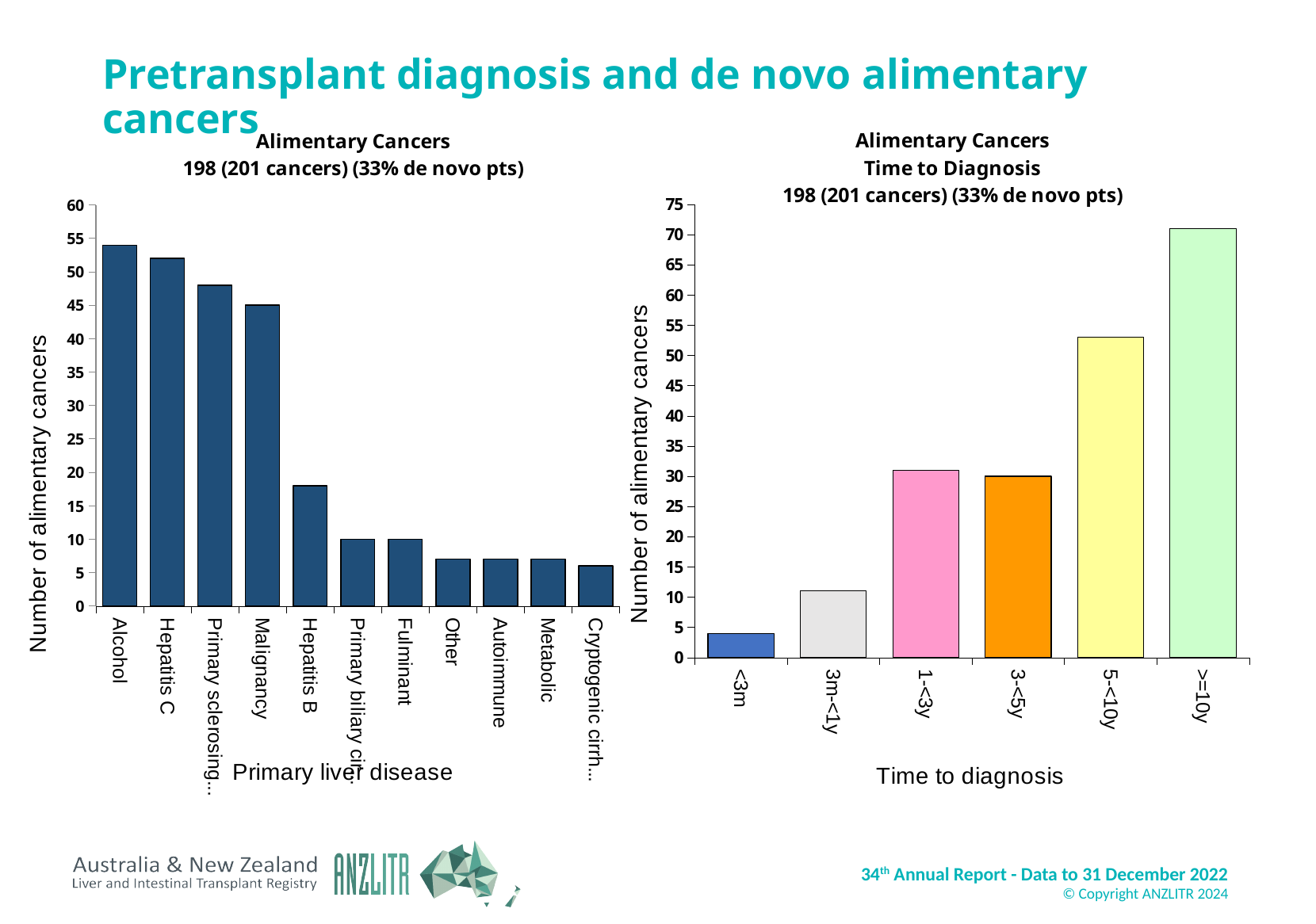
In the right chart (Alimentary Cancers Time to Diagnosis), is the value for 5-<10y greater or less than 50? greater In the left chart (Alimentary Cancers by primary liver disease), is the value for Hepatitis B greater or less than 20? less In the right chart (Alimentary Cancers Time to Diagnosis), how many time-to-diagnosis categories are shown? 6 In the right chart (Alimentary Cancers Time to Diagnosis), which time-to-diagnosis category has the highest number of alimentary cancers? >=10y In the left chart (Alimentary Cancers by primary liver disease), is the value for Hepatitis C greater or less than 50? greater In the left chart (Alimentary Cancers by primary liver disease), how many primary liver disease categories are shown? 11 In the right chart (Alimentary Cancers Time to Diagnosis), which time-to-diagnosis category has the lowest number of alimentary cancers? <3m In the left chart (Alimentary Cancers by primary liver disease), what kind of chart is it? bar chart In the right chart (Alimentary Cancers Time to Diagnosis), do the values generally rise or fall as time to diagnosis increases along the x axis? rise In the left chart (Alimentary Cancers by primary liver disease), which is larger, the value for Malignancy or the value for Hepatitis B? Malignancy In the left chart (Alimentary Cancers by primary liver disease), which primary liver disease has the highest number of alimentary cancers? Alcohol